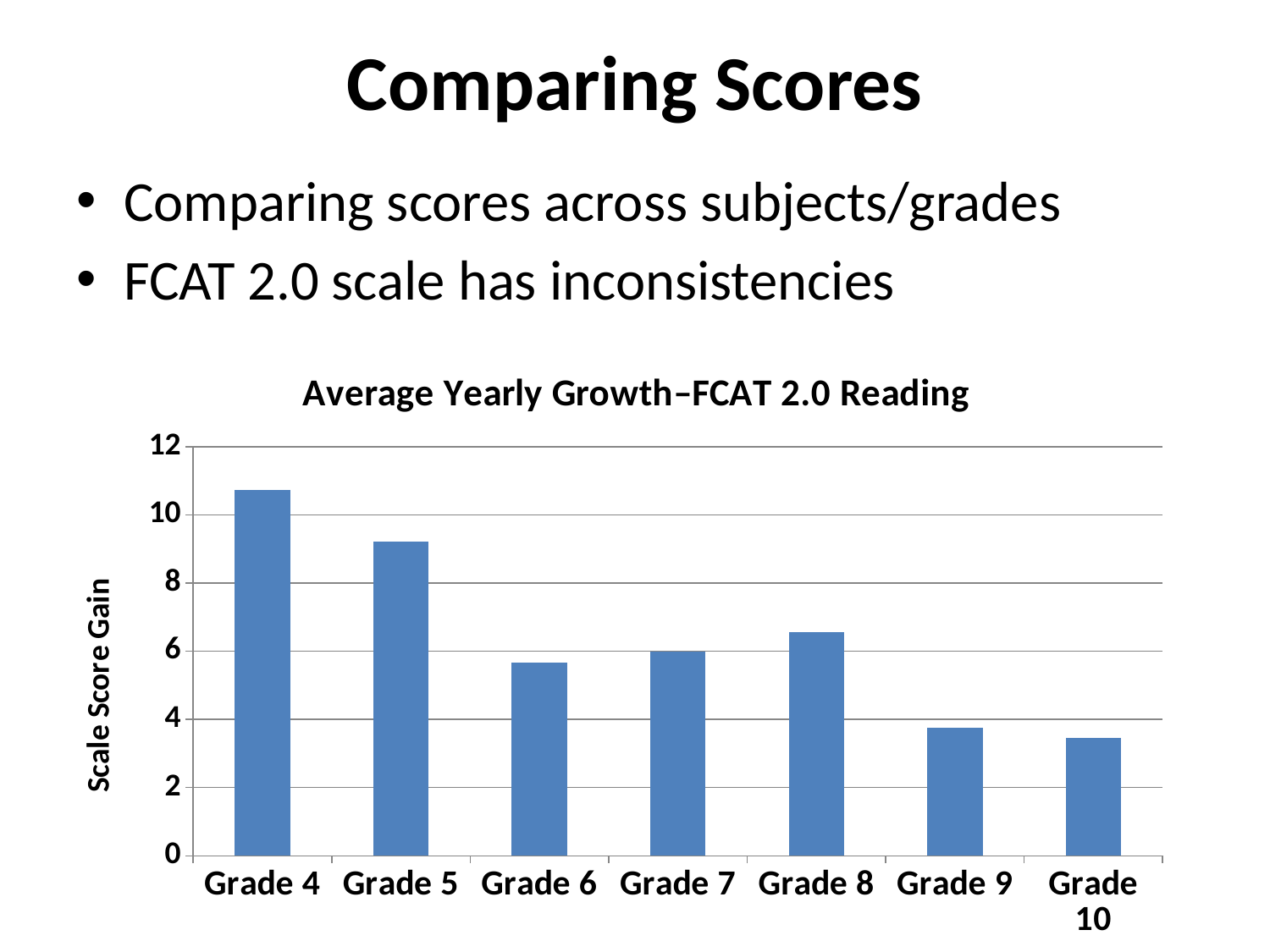
Which grade has the lowest average yearly growth? Grade 10 Is the value for Grade 4 greater or less than 10? greater What is the title of the chart? Average Yearly Growth–FCAT 2.0 Reading How many grades are shown in the chart? 7 Overall, do the values rise or fall from Grade 4 to Grade 10? fall Is the value for Grade 8 greater or less than 6? greater Which has a larger scale score gain, Grade 5 or Grade 8? Grade 5 Is the value for Grade 9 greater or less than 4? less What is the label of the vertical axis? Scale Score Gain What type of chart is shown on the slide? bar chart Which grade has the highest average yearly growth? Grade 4